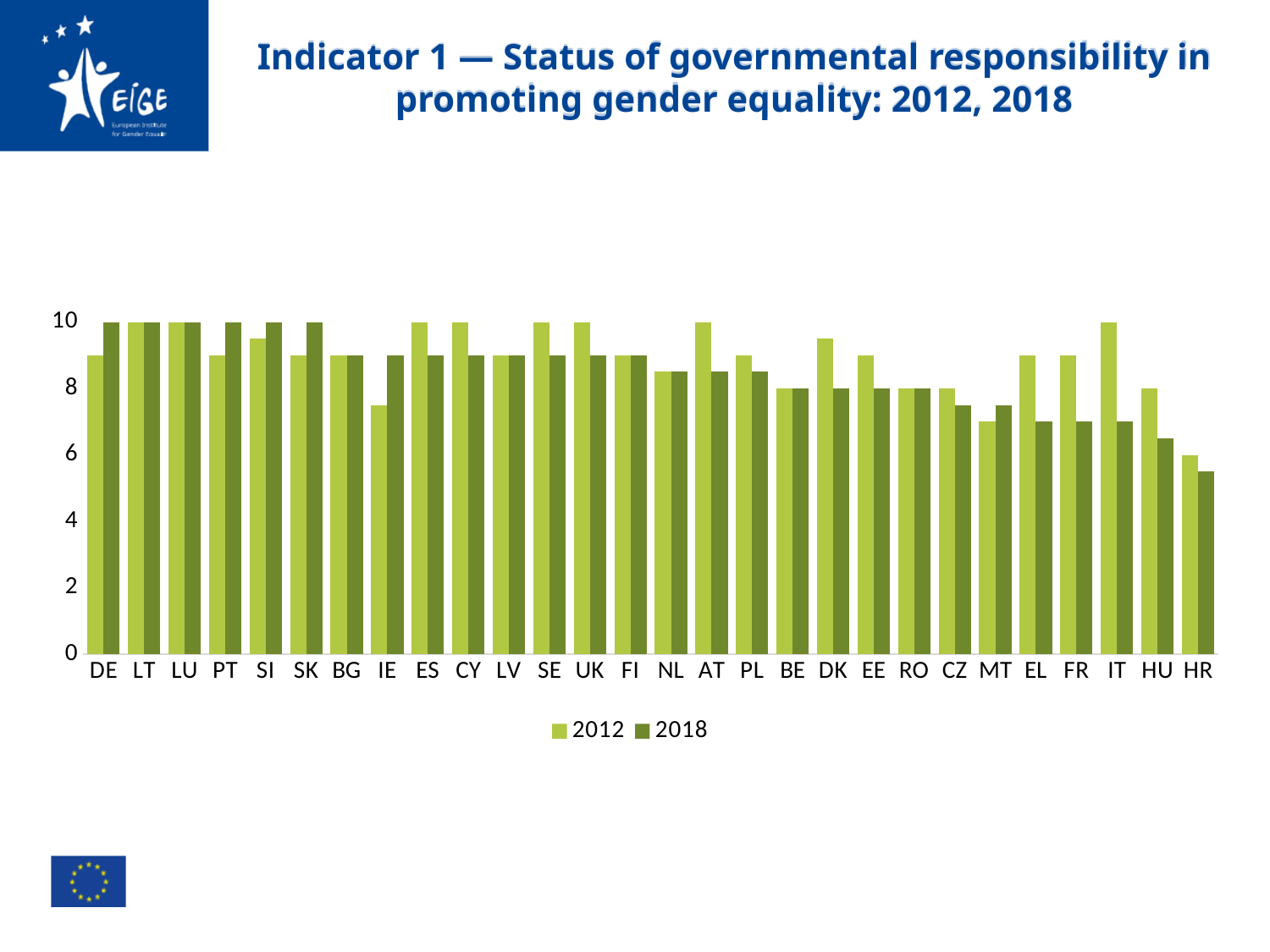
Is the 2012 value for IE greater or less than 8? less What is the 2012 value for BE? 8 What is the 2018 value for DE? 10 How many countries are shown on the x axis? 28 Which series are listed in the legend? 2012 and 2018 What is the 2012 value for LT? 10 Do the 2018 values generally rise or fall from left to right along the x axis? fall Which country has the lowest 2018 value? HR How many series does the legend list? 2 For IT, which is larger: the 2012 value or the 2018 value? 2012 What type of chart is shown on the slide? bar chart Is the 2012 value for DE greater or less than 8? greater